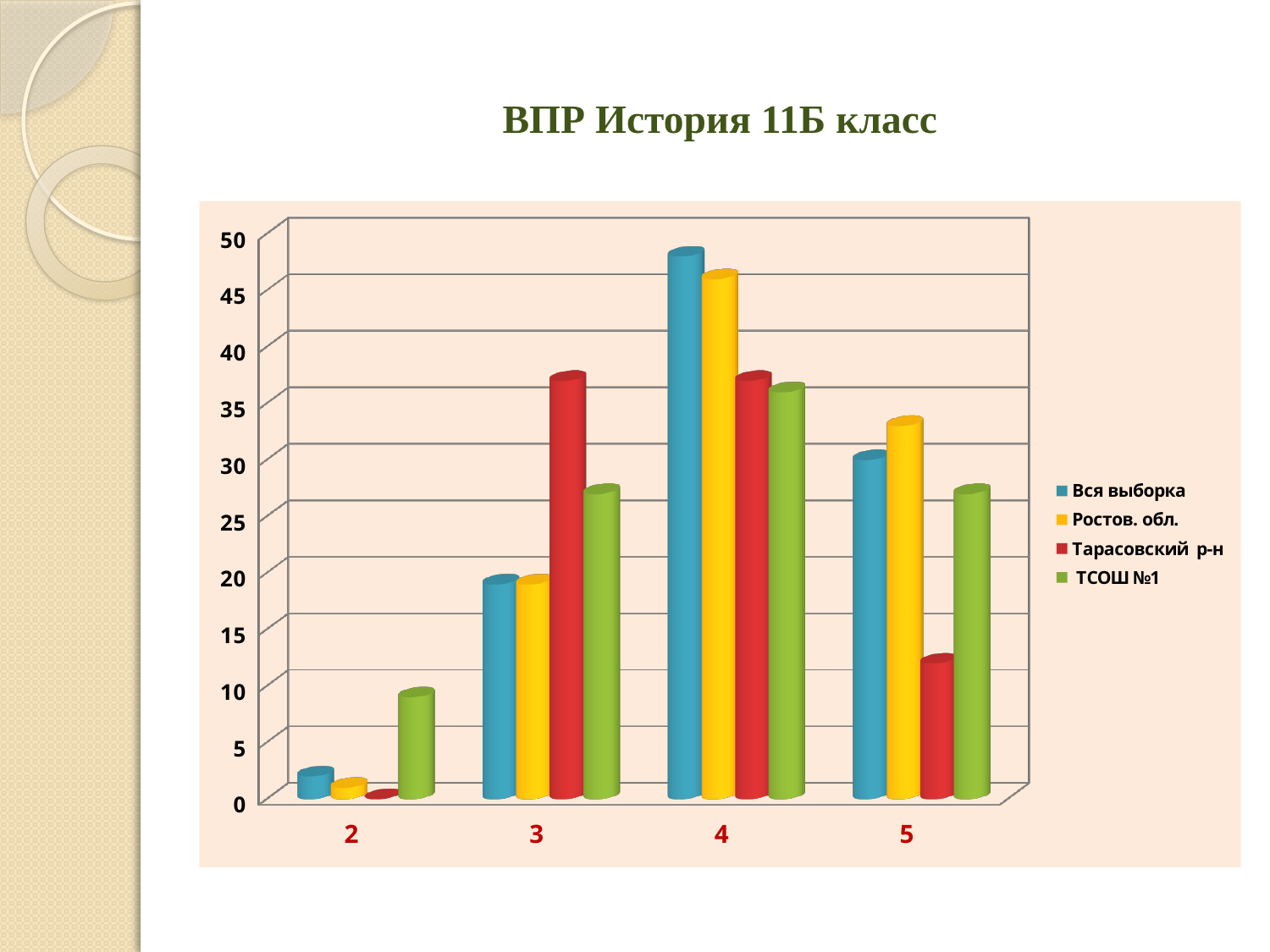
Is the value for Вся выборка in category 4 greater or less than 45? greater In category 3, which is larger: Тарасовский р-н or ТСОШ №1? Тарасовский р-н For which category is the value of ТСОШ №1 lowest? 2 For which category is the value of Вся выборка highest? 4 What is the title of the chart? ВПР История 11Б класс How many series does the legend list? 4 In category 5, which is larger: Ростов. обл. or Тарасовский р-н? Ростов. обл. Which series is shown in red in the legend? Тарасовский р-н How many categories are shown on the x axis? 4 Is the value for Тарасовский р-н in category 5 greater or less than 15? less What kind of chart is shown on the slide? bar chart Is the value for ТСОШ №1 in category 2 greater or less than 5? greater